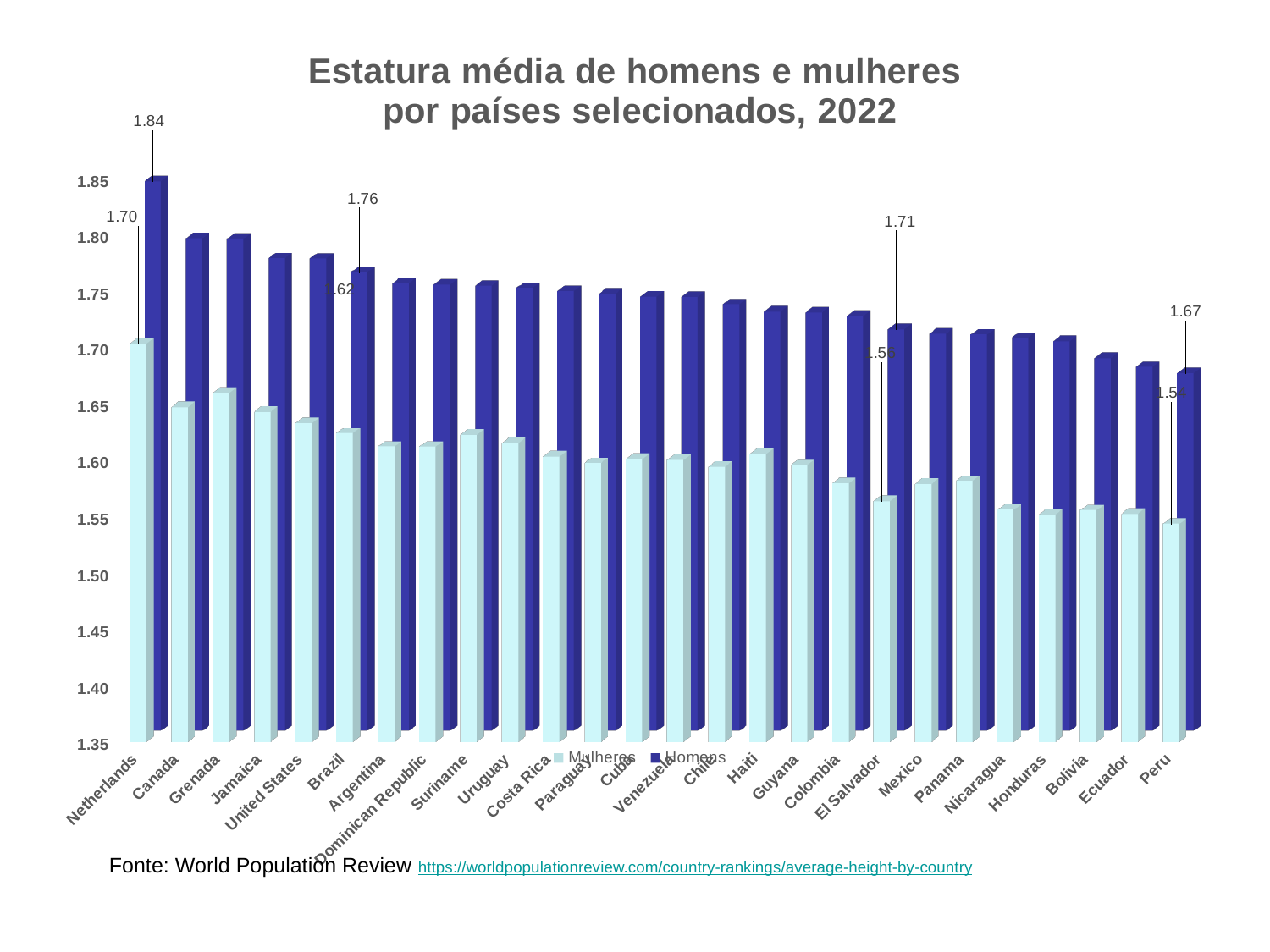
What is the difference between the Homens and Mulheres values for the Netherlands? 0.14 What is the value for Homens in Brazil? 1.76 What is the value for Homens in Peru? 1.67 How many countries are shown on the x axis? 26 What is the value for Homens in the Netherlands? 1.84 What is the value for Mulheres in the Netherlands? 1.70 What kind of chart is shown on the slide? Bar chart How many series does the legend list? 2 What is the value for Mulheres in Peru? 1.54 Is the value for Mulheres in Canada greater or less than 1.60? greater Do the Homens values rise or fall from left to right along the x axis? Fall Which country has the highest value for Homens? Netherlands